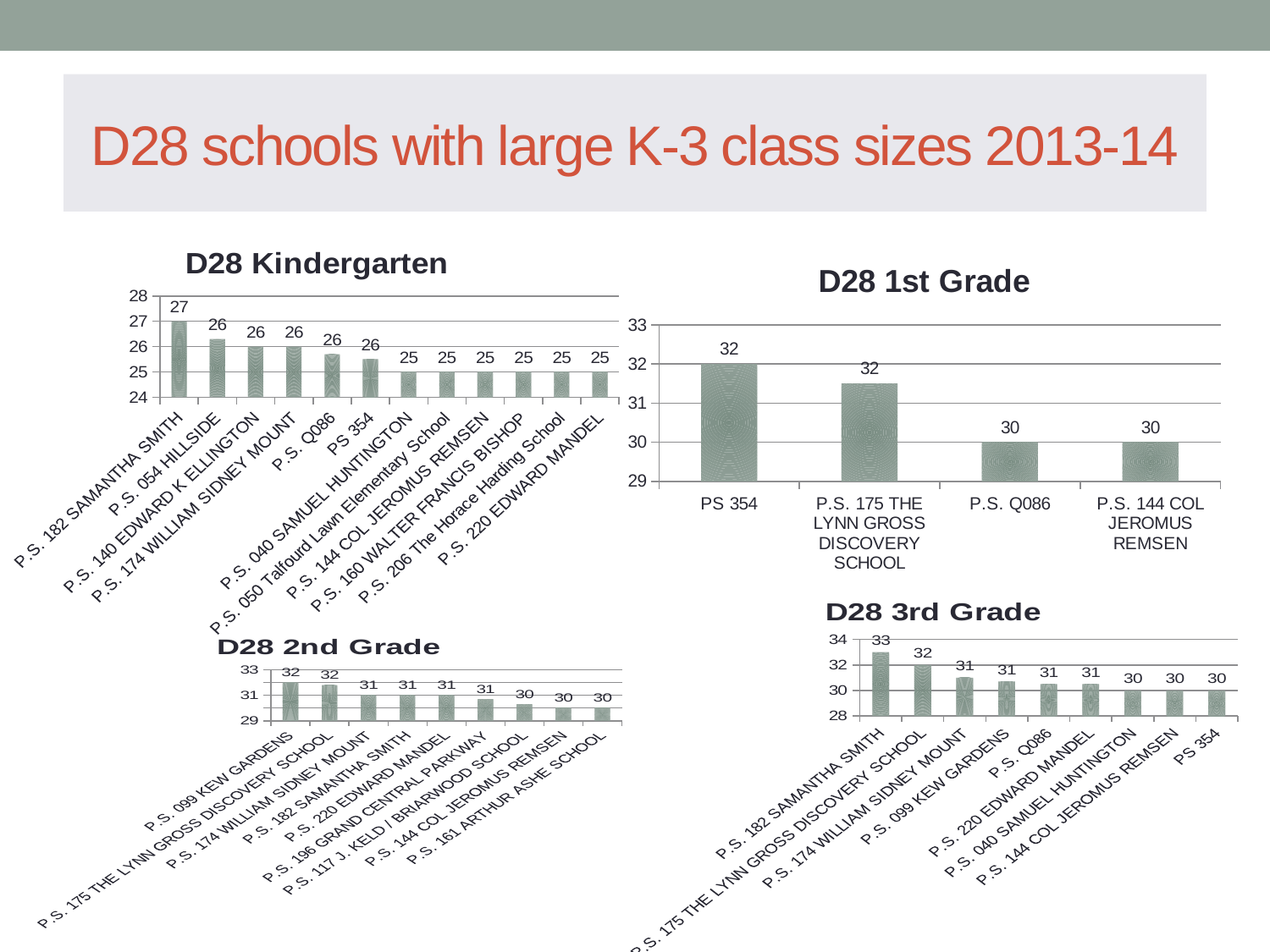
In the D28 1st Grade chart, what is the difference between the values for PS 354 and P.S. 144 COL JEROMUS REMSEN? 2 What kind of chart is the D28 3rd Grade chart? Bar chart In the D28 Kindergarten chart, what is the value for P.S. 182 SAMANTHA SMITH? 27 In the D28 3rd Grade chart, which school has the highest value? P.S. 182 SAMANTHA SMITH In the D28 2nd Grade chart, which is larger, the value for P.S. 175 THE LYNN GROSS DISCOVERY SCHOOL or the value for P.S. 161 ARTHUR ASHE SCHOOL? P.S. 175 THE LYNN GROSS DISCOVERY SCHOOL In the D28 Kindergarten chart, do the values rise or fall from left to right? Fall In the D28 1st Grade chart, how many schools are shown? 4 In the D28 Kindergarten chart, how many schools are shown? 12 In the D28 3rd Grade chart, what is the value for P.S. 040 SAMUEL HUNTINGTON? 30 In the D28 2nd Grade chart, what is the value for P.S. 099 KEW GARDENS? 32 In the D28 Kindergarten chart, which school has the highest value? P.S. 182 SAMANTHA SMITH In the D28 1st Grade chart, what is the value for P.S. Q086? 30